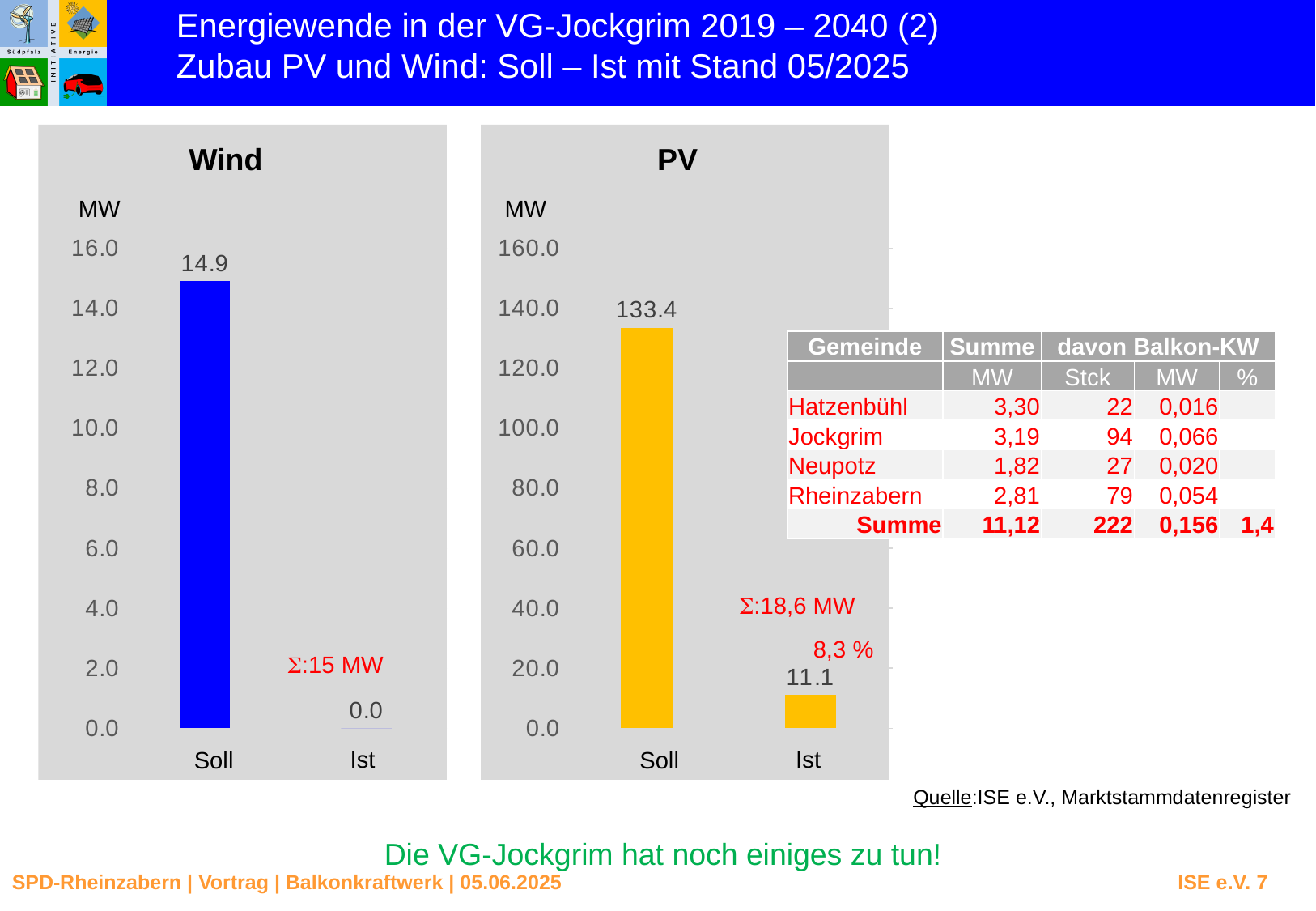
In the PV chart, what is the value for Soll? 133.4 In the PV chart, which category has the higher value, Soll or Ist? Soll In the PV chart, is the value for Ist greater or less than 20.0? less How many categories are shown in the PV chart? 2 In the Wind chart, what is the value for Soll? 14.9 In the PV chart, what is the difference between Soll and Ist? 122.3 What unit is shown on the y axis of the PV chart? MW In the Wind chart, what is the value for Ist? 0.0 In the Wind chart, what is the difference between Soll and Ist? 14.9 What kind of chart is the Wind chart? bar chart In the Wind chart, which category has the lowest value? Ist In the PV chart, what is the value for Ist? 11.1